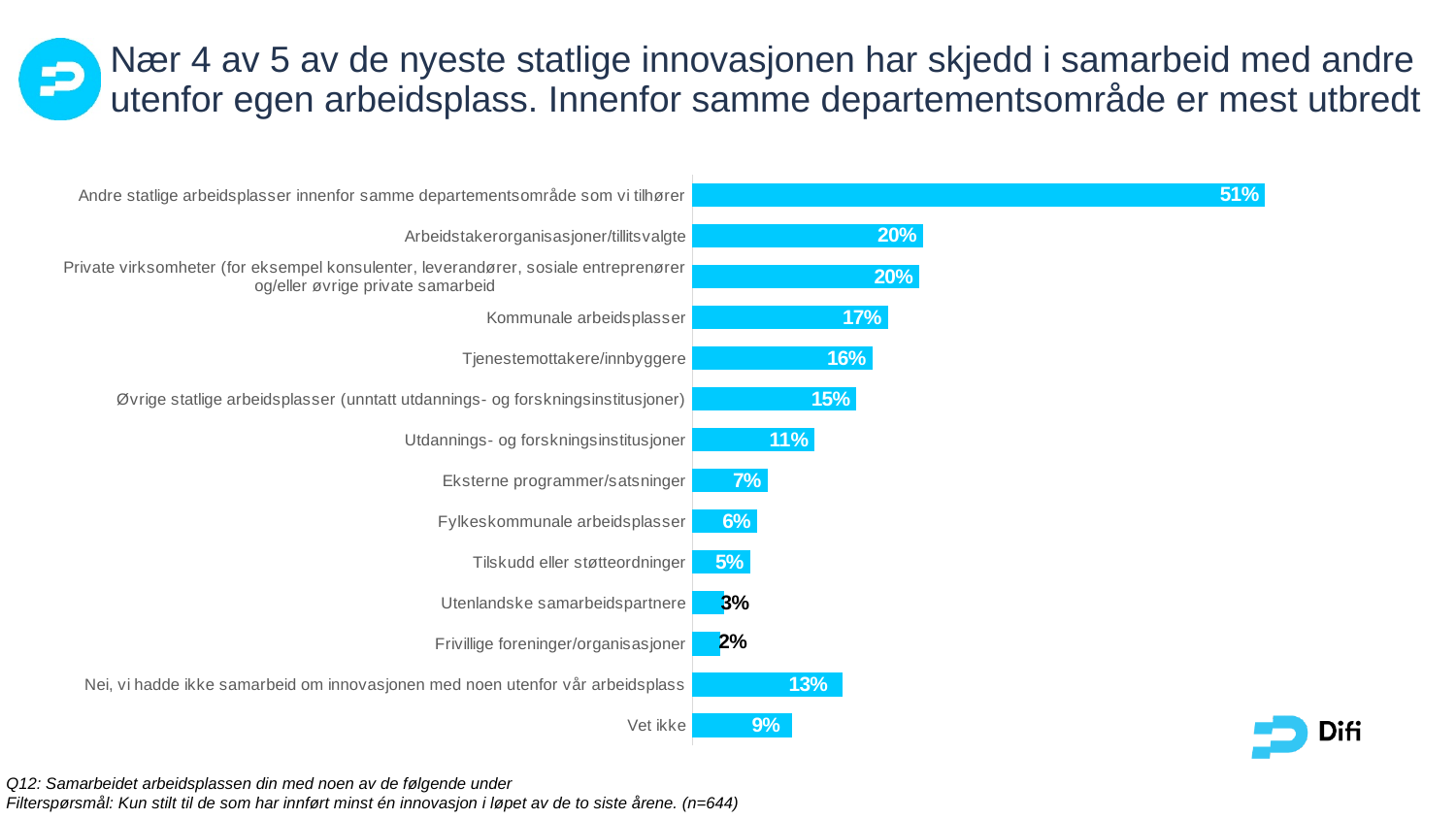
Which category has the lowest value? Frivillige foreninger/organisasjoner What is the value for "Utdannings- og forskningsinstitusjoner"? 11% What is the value for "Kommunale arbeidsplasser"? 17% What kind of chart is shown on the slide? Bar chart Which is larger, the value for "Fylkeskommunale arbeidsplasser" or the value for "Tilskudd eller støtteordninger"? Fylkeskommunale arbeidsplasser What is the difference between the values for "Tjenestemottakere/innbyggere" and "Eksterne programmer/satsninger"? 9% How many categories are shown in the chart? 14 What is the value for "Nei, vi hadde ikke samarbeid om innovasjonen med noen utenfor vår arbeidsplass"? 13% What is the difference between the values for "Andre statlige arbeidsplasser innenfor samme departementsområde som vi tilhører" and "Arbeidstakerorganisasjoner/tillitsvalgte"? 31% Which category has the highest value? Andre statlige arbeidsplasser innenfor samme departementsområde som vi tilhører Which is larger, the value for "Utenlandske samarbeidspartnere" or the value for "Vet ikke"? Vet ikke What is the value for "Vet ikke"? 9%